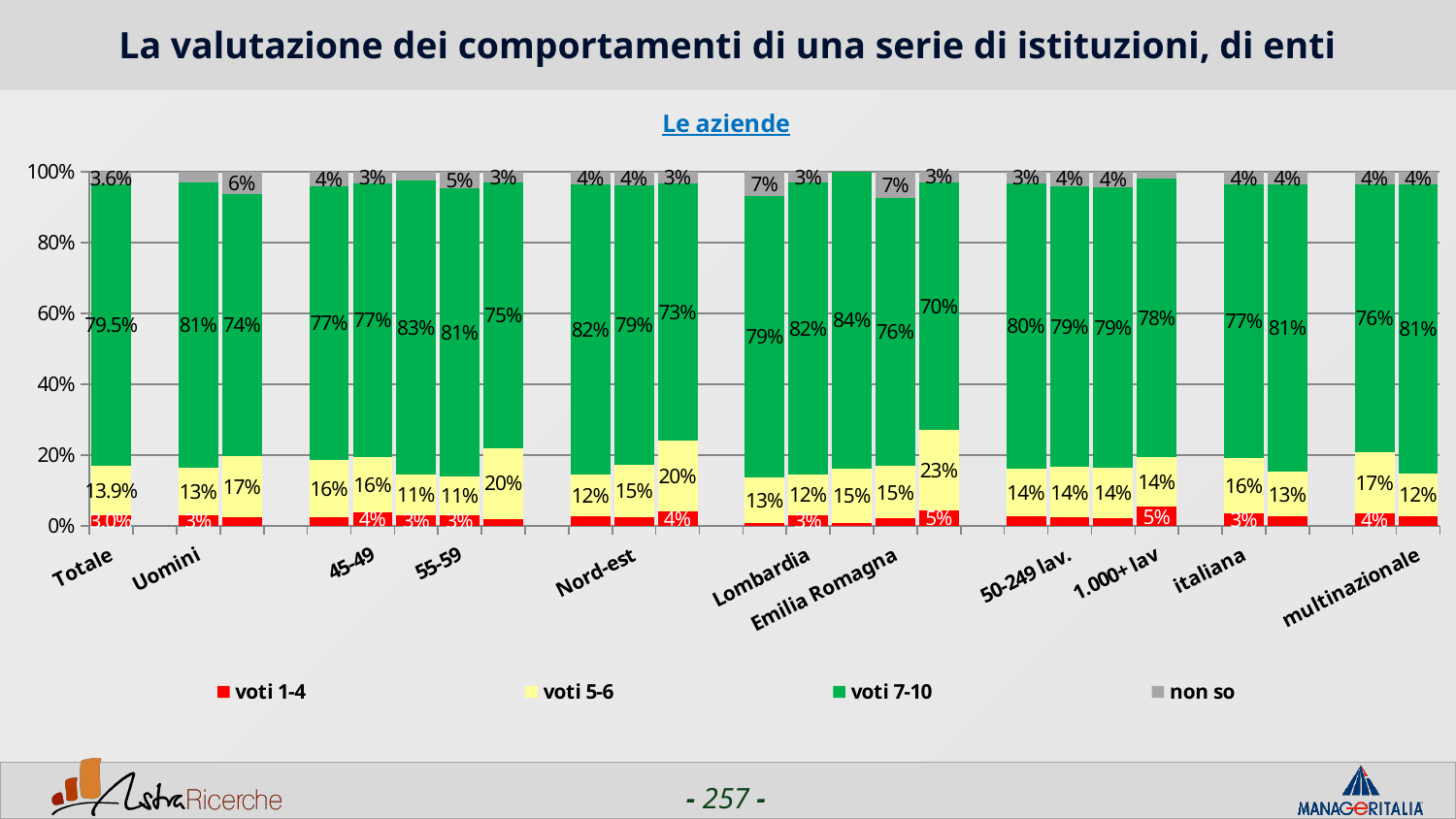
What is the value of 'voti 1-4' for Totale? 3.0% What is the value of 'voti 5-6' for multinazionale? 12% Is the 'voti 7-10' value for Totale greater or less than 60%? greater What is the title of the chart? Le aziende What are the four legend entries of the chart? voti 1-4, voti 5-6, voti 7-10, non so Which is larger, the 'voti 7-10' value for Uomini or for Totale? Uomini What is the value of 'voti 7-10' for Uomini? 81% What is the value of 'voti 5-6' for Totale? 13.9% What is the value of 'voti 7-10' for Totale? 79.5% What type of chart is shown on the slide? stacked bar chart What is the value of 'non so' for Totale? 3.6% How many series does the legend list? 4